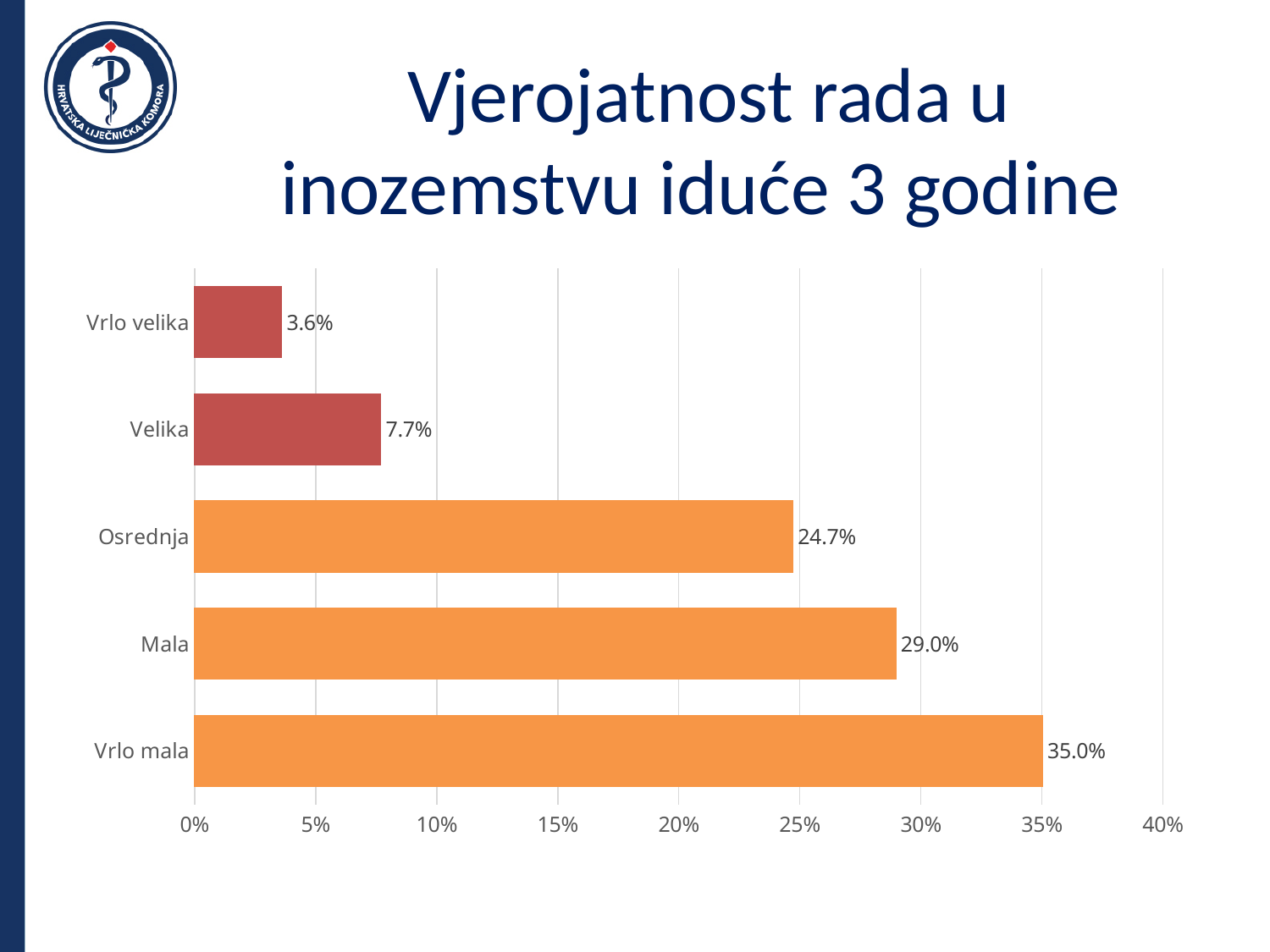
What is the difference between the values for Velika and Vrlo velika? 4.1% Is the value for Osrednja greater or less than 25%? less Which category has the lowest value? Vrlo velika What is the value for Velika? 7.7% What is the value for Vrlo mala? 35.0% Which category has the highest value? Vrlo mala What kind of chart is shown on the slide? bar chart How many categories are shown in the chart? 5 What is the difference between the values for Vrlo mala and Mala? 6.0% What is the value for Vrlo velika? 3.6% What is the value for Osrednja? 24.7% Which is larger, the value for Osrednja or the value for Mala? Mala